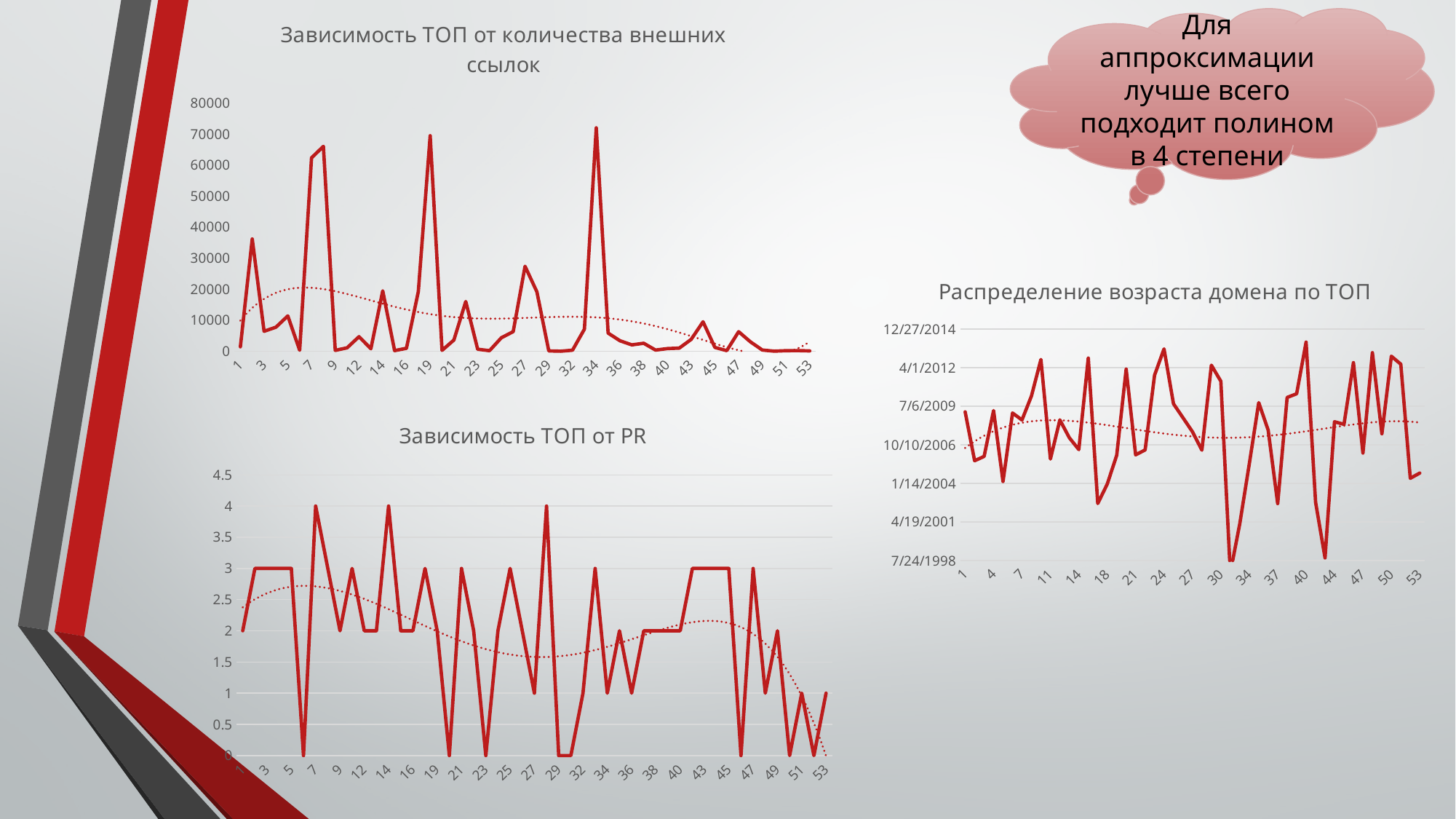
In the chart "Зависимость ТОП от PR", what is the value at point 7? 4 In the chart "Зависимость ТОП от количества внешних ссылок", which is larger, the value at point 19 or the value at point 27? point 19 In the chart "Зависимость ТОП от количества внешних ссылок", is the value at point 53 greater or less than 10000? less In the chart "Зависимость ТОП от PR", what is the value at point 6? 0 In the chart "Зависимость ТОП от PR", what is the value at point 1? 2 What kind of chart is the chart titled "Зависимость ТОП от PR"? line chart What kind of chart is the chart titled "Распределение возраста домена по ТОП"? line chart In the chart "Зависимость ТОП от PR", what is the value at point 53? 1 In the chart "Зависимость ТОП от PR", which is larger, the value at point 7 or the value at point 1? point 7 In the chart "Зависимость ТОП от количества внешних ссылок", is the value at point 1 greater or less than 30000? less In the chart "Зависимость ТОП от количества внешних ссылок", is the value at point 7 greater or less than 60000? greater How many charts are shown on the slide? 3